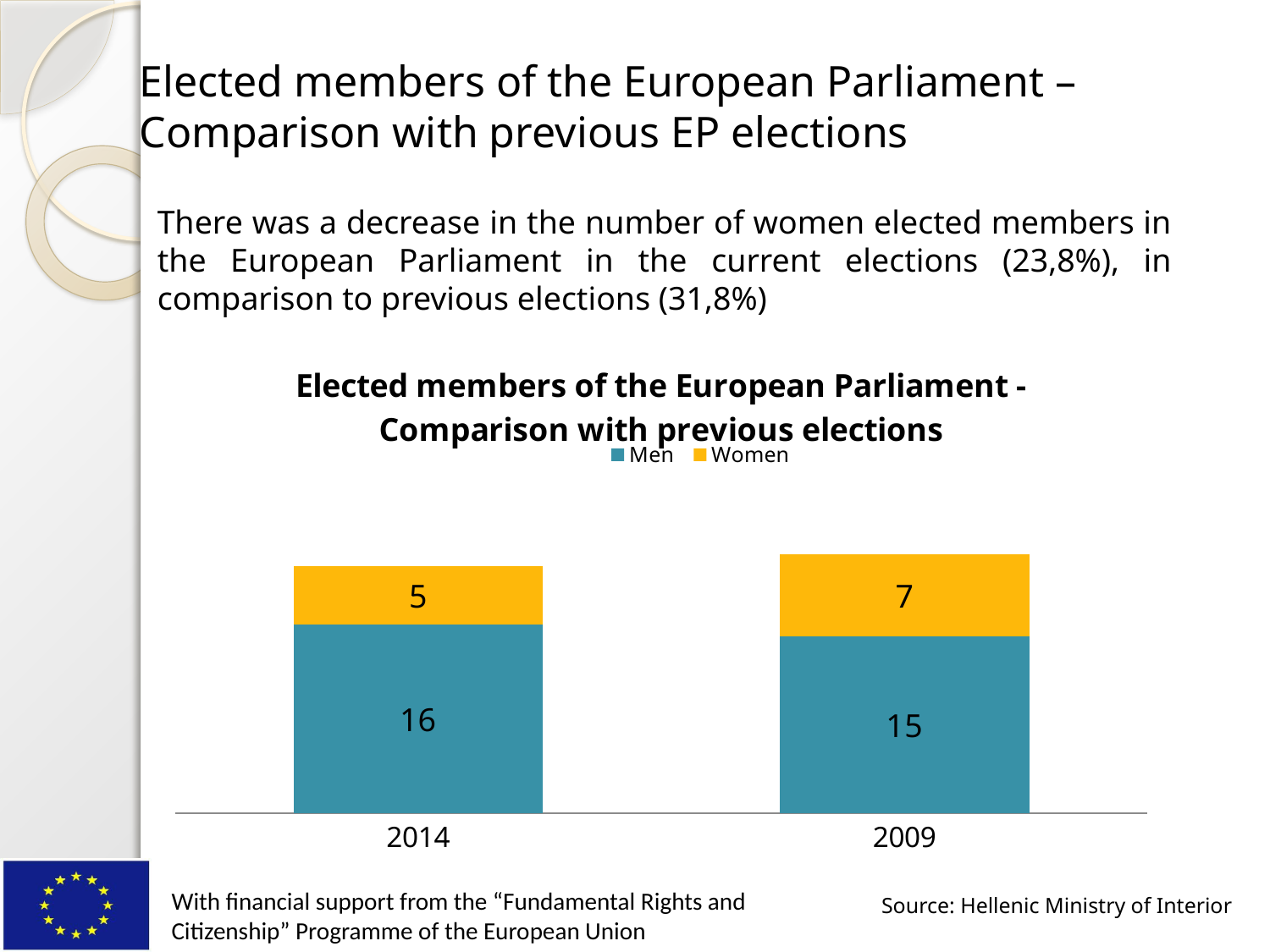
What is the value for Women in 2009? 7 What is the value for Men in 2014? 16 What kind of chart is shown? Stacked bar chart What is the value for Women in 2014? 5 What is the difference between the Women values for 2009 and 2014? 2 Which year has the higher value for Men? 2014 Which year has the higher value for Women? 2009 How many categories are shown on the x axis? 2 How many series does the legend list? 2 What is the value for Men in 2009? 15 What is the total of the stacked bar for 2014? 21 What is the total of the stacked bar for 2009? 22